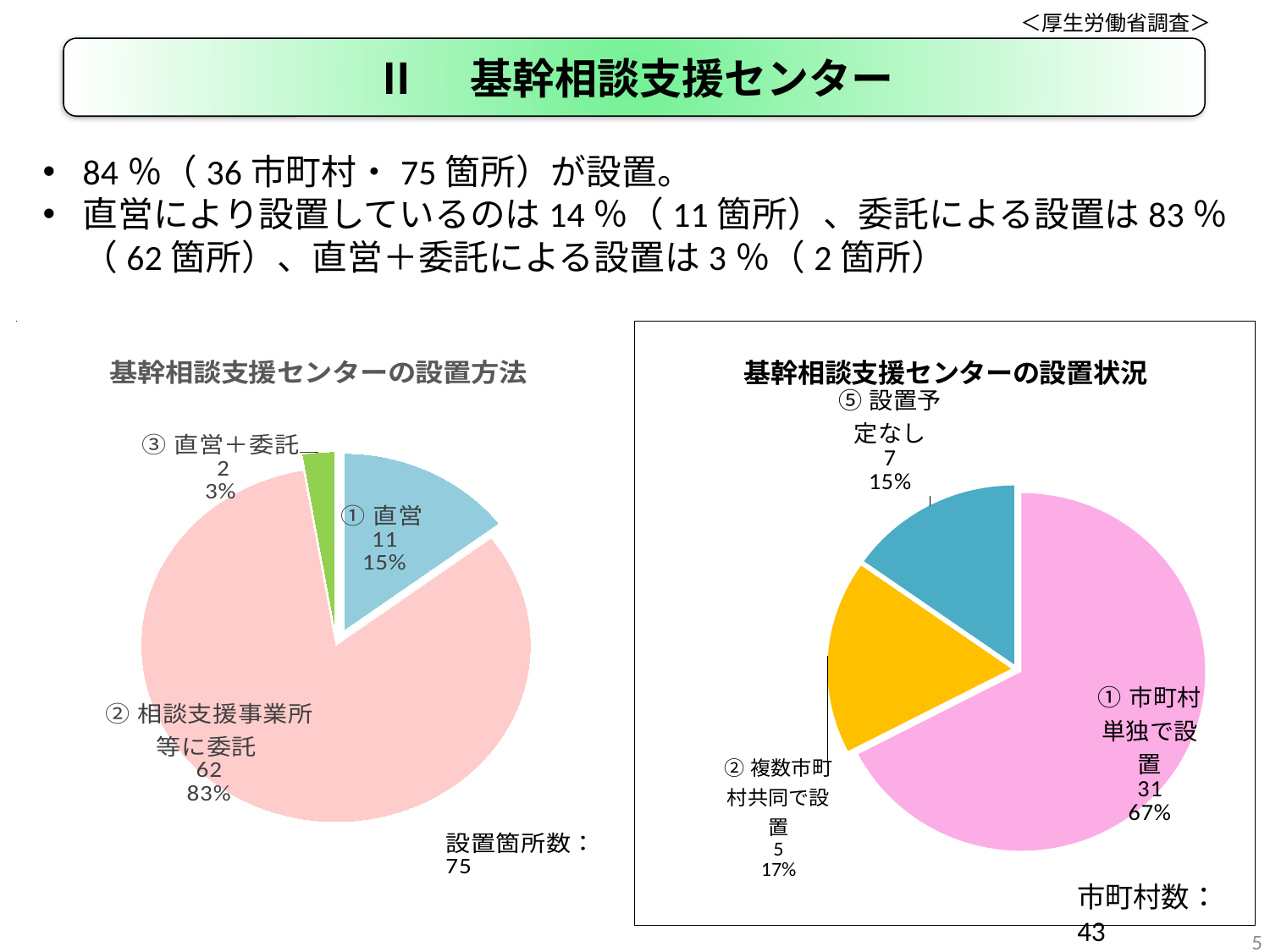
In the right pie chart titled 基幹相談支援センターの設置状況, which category has the largest slice? ① 市町村単独で設置 What is the title of the pie chart on the left of the slide? 基幹相談支援センターの設置方法 In the left pie chart titled 基幹相談支援センターの設置方法, how many categories are shown? 3 In the left pie chart titled 基幹相談支援センターの設置方法, what is the difference between the values for ② 相談支援事業所等に委託 and ① 直営? 51 In the right pie chart titled 基幹相談支援センターの設置状況, what is the total number of 市町村 shown? 43 In the right pie chart titled 基幹相談支援センターの設置状況, what percentage share is shown for ① 市町村単独で設置? 67% In the right pie chart titled 基幹相談支援センターの設置状況, what is the value for ⑤ 設置予定なし? 7 In the left pie chart titled 基幹相談支援センターの設置方法, which category has the smallest slice? ③ 直営＋委託 What kind of chart is the chart titled 基幹相談支援センターの設置状況 on the right? Pie chart In the left pie chart titled 基幹相談支援センターの設置方法, what percentage share is shown for ② 相談支援事業所等に委託? 83% In the left pie chart titled 基幹相談支援センターの設置方法, what is the value for ① 直営? 11